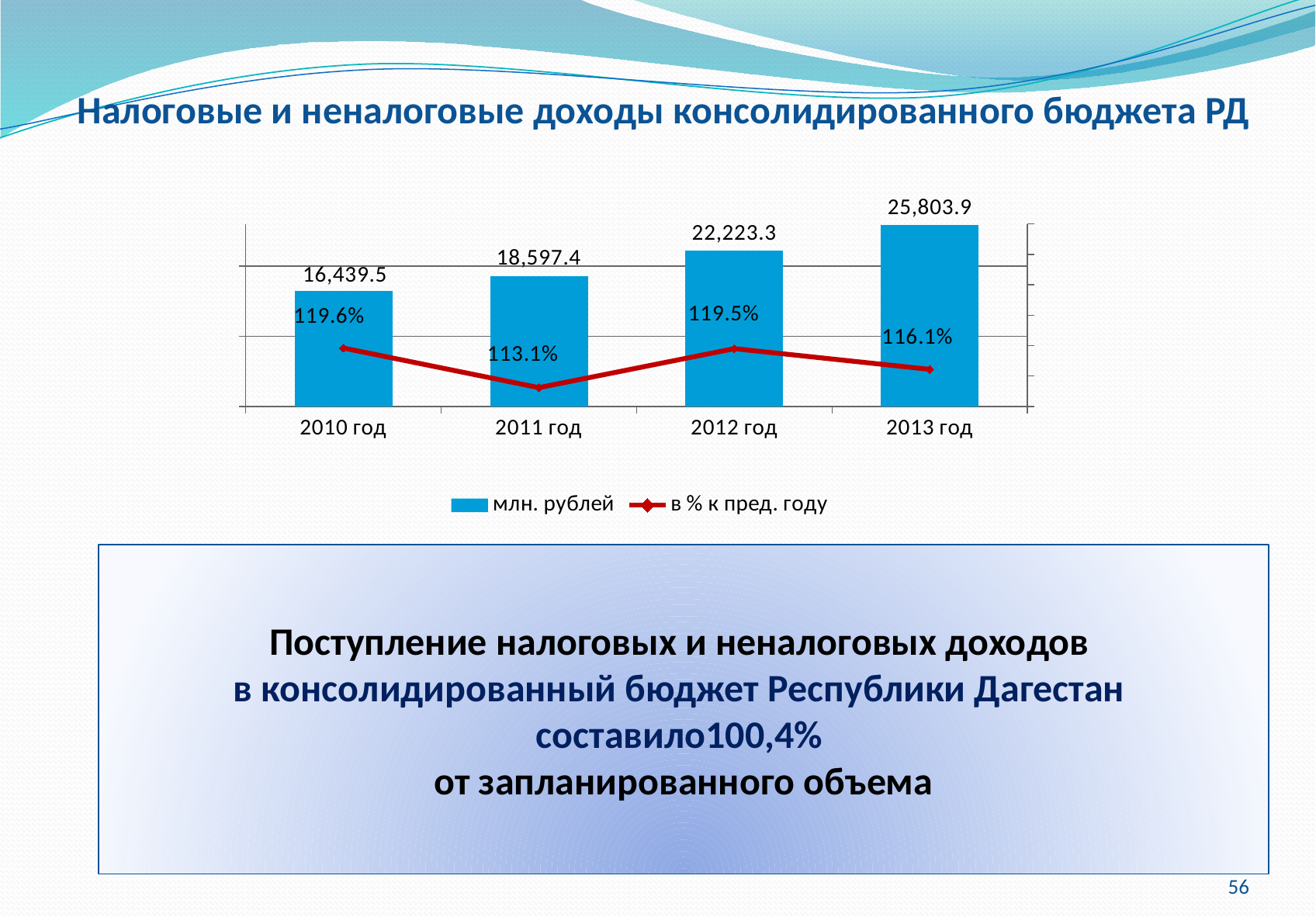
Do the млн. рублей bar values rise or fall from 2010 год to 2013 год? rise Which is larger, the в % к пред. году value for 2013 год or for 2011 год? 2013 год How many series does the legend list? 2 What is the difference between the млн. рублей values for 2013 год and 2010 год? 9,364.4 What is the value of the млн. рублей bar for 2010 год? 16,439.5 What is the value of the в % к пред. году line for 2011 год? 113.1% Which year has the highest млн. рублей value? 2013 год How many years are shown on the x axis? 4 What is the value of the в % к пред. году line for 2012 год? 119.5% Which year has the lowest в % к пред. году value? 2011 год What is the value of the млн. рублей bar for 2013 год? 25,803.9 What is the difference between the млн. рублей values for 2012 год and 2011 год? 3,625.9